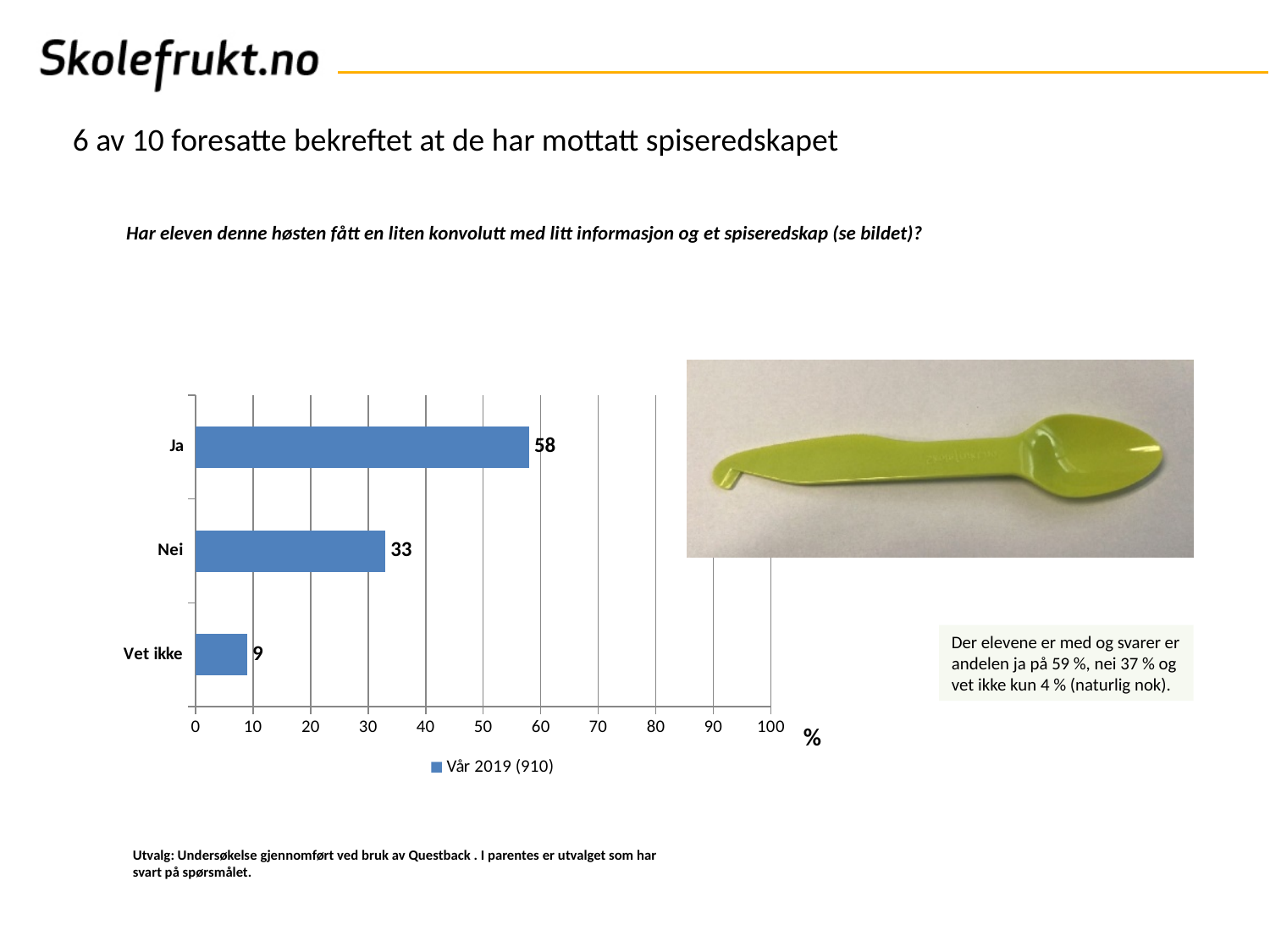
What is the value for "Vet ikke" in the bar chart? 9 What is the difference between the values for "Nei" and "Vet ikke"? 24 How many categories are shown in the bar chart? 3 Is the value for "Ja" greater or less than 50? greater What is the value for "Ja" in the bar chart? 58 Which is larger, the value for "Nei" or the value for "Vet ikke"? Nei What is the difference between the values for "Ja" and "Nei"? 25 Which category has the lowest value in the bar chart? Vet ikke Which category has the highest value in the bar chart? Ja What series does the legend of the bar chart list? Vår 2019 (910) What is the value for "Nei" in the bar chart? 33 What kind of chart is shown on the slide? bar chart